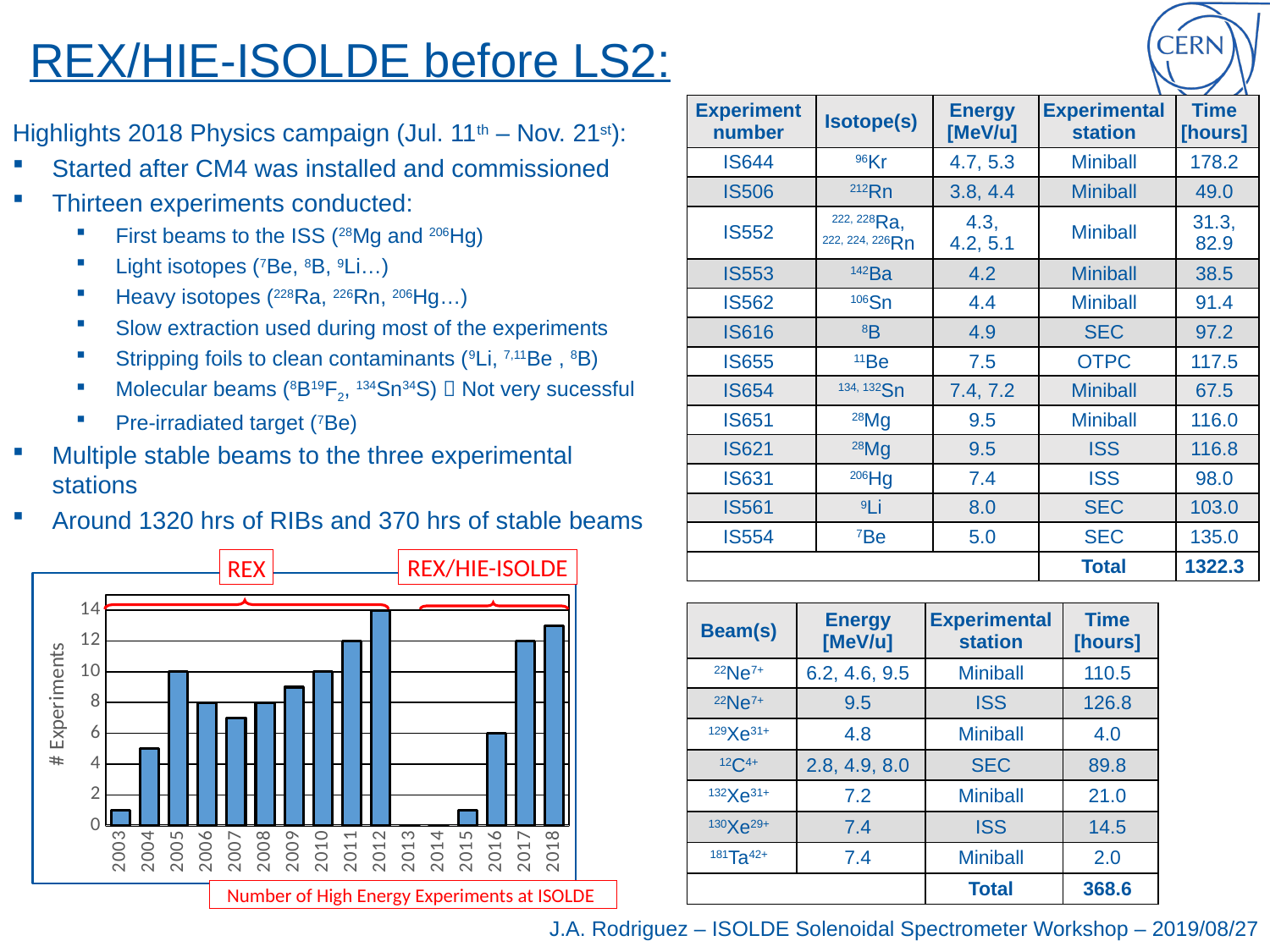
In the chart 'Number of High Energy Experiments at ISOLDE', is the value for 2018 greater or less than 12? greater What kind of chart is shown at the bottom left of the slide? bar chart In the chart 'Number of High Energy Experiments at ISOLDE', how many years are shown on the x axis? 16 In the chart 'Number of High Energy Experiments at ISOLDE', is the value for 2004 greater or less than 6? less In the chart 'Number of High Energy Experiments at ISOLDE', how many experiments were there in 2005? 10 In the chart 'Number of High Energy Experiments at ISOLDE', how many experiments were there in 2012? 14 What is the label on the y axis of the chart 'Number of High Energy Experiments at ISOLDE'? # Experiments In the chart 'Number of High Energy Experiments at ISOLDE', do the values rise or fall from 2014 to 2018? rise In the chart 'Number of High Energy Experiments at ISOLDE', what is the difference between the number of experiments in 2012 and in 2011? 2 In the chart 'Number of High Energy Experiments at ISOLDE', which year has the highest number of experiments? 2012 In the chart 'Number of High Energy Experiments at ISOLDE', which year has more experiments, 2005 or 2004? 2005 In the chart 'Number of High Energy Experiments at ISOLDE', how many experiments were there in 2017? 12